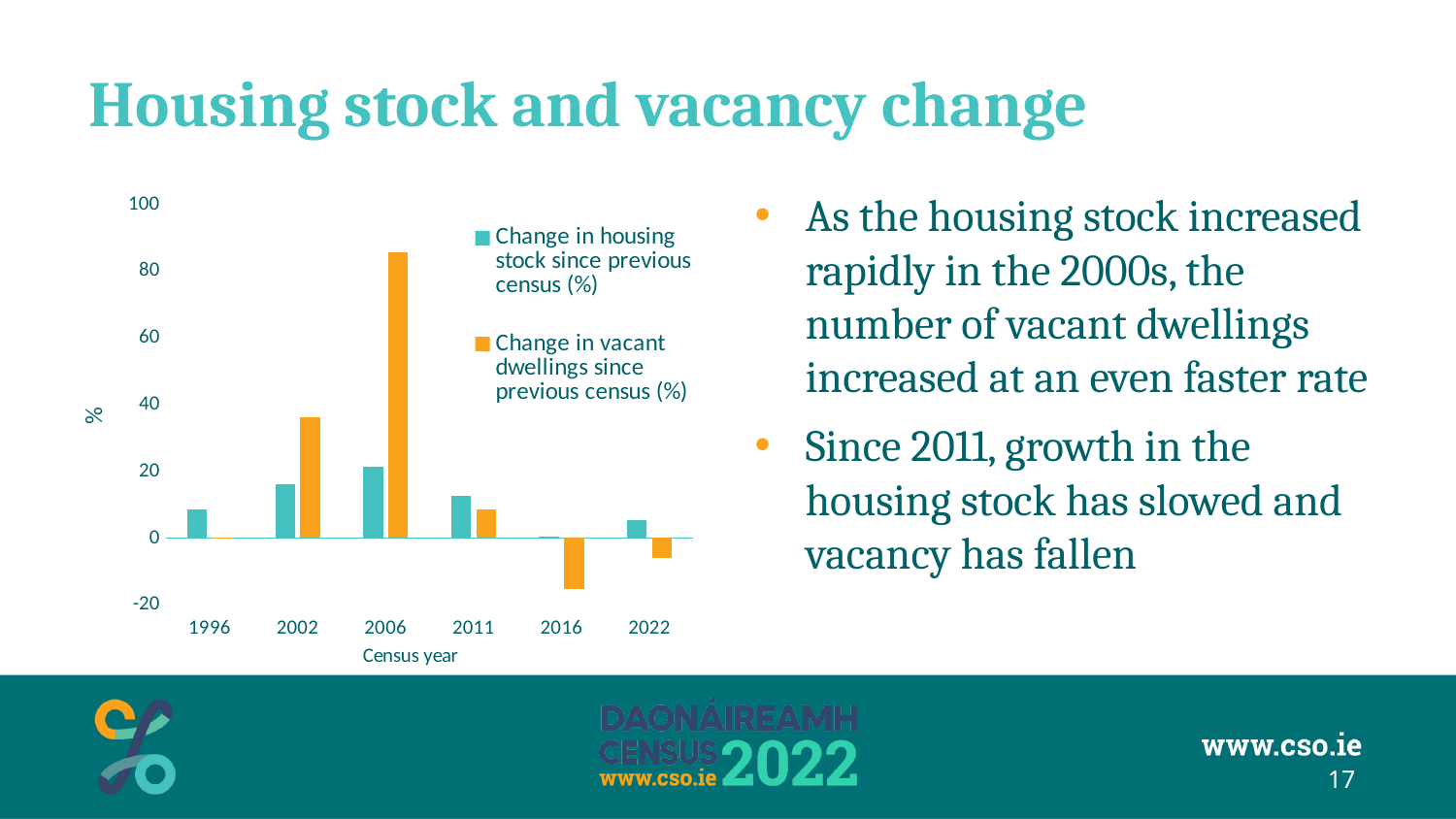
Is the change in vacant dwellings for 2016 greater or less than 0? less Is the change in vacant dwellings for 2006 greater or less than 60? greater Does the change in vacant dwellings rise or fall from 2006 to 2016? Fall How many census years are shown on the x axis of the chart? 6 What is the title of the x axis of the chart? Census year In which census year is the change in vacant dwellings since previous census highest? 2006 Is the change in vacant dwellings for 2002 greater or less than 20? greater In which census year is the change in vacant dwellings since previous census lowest? 2016 In which census year is the change in housing stock since previous census highest? 2006 For 2006, which is larger: the change in housing stock or the change in vacant dwellings? Change in vacant dwellings What kind of chart is shown on the slide? Bar chart How many series does the chart legend list? 2